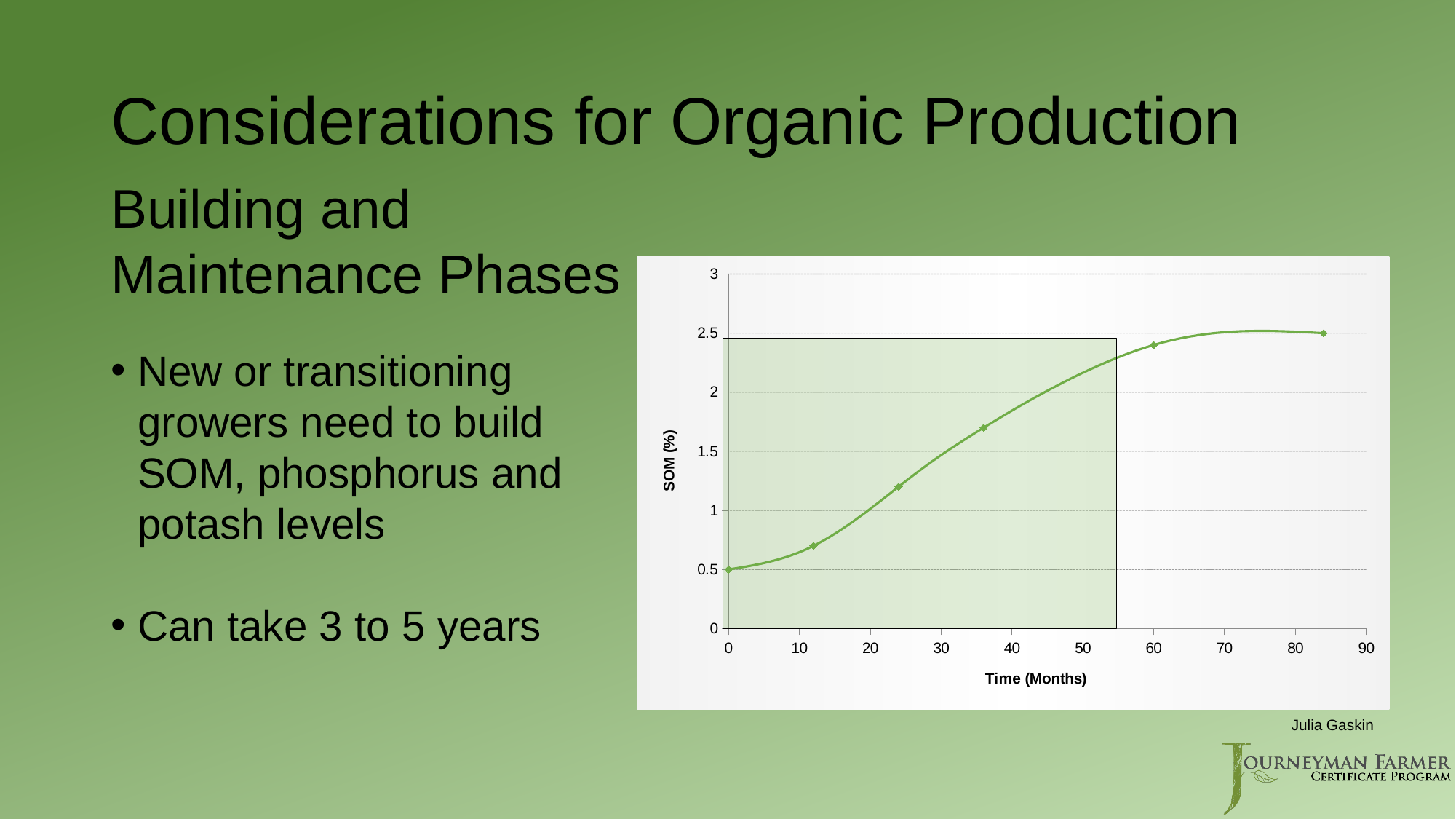
What is the label of the y axis of the chart? SOM (%) What kind of chart is shown on the slide? line chart At which time point is the SOM (%) value lowest? 0 months Is the SOM (%) value at 24 months greater or less than 1? greater What is the label of the x axis of the chart? Time (Months) Which has the larger SOM (%) value, 24 months or 60 months? 60 months Is the SOM (%) value at 36 months greater or less than 1.5? greater What is the SOM (%) value at 84 months? 2.5 What is the SOM (%) value at 0 months? 0.5 Do the SOM (%) values rise or fall as Time (Months) increases? rise Is the SOM (%) value at 12 months greater or less than 1? less